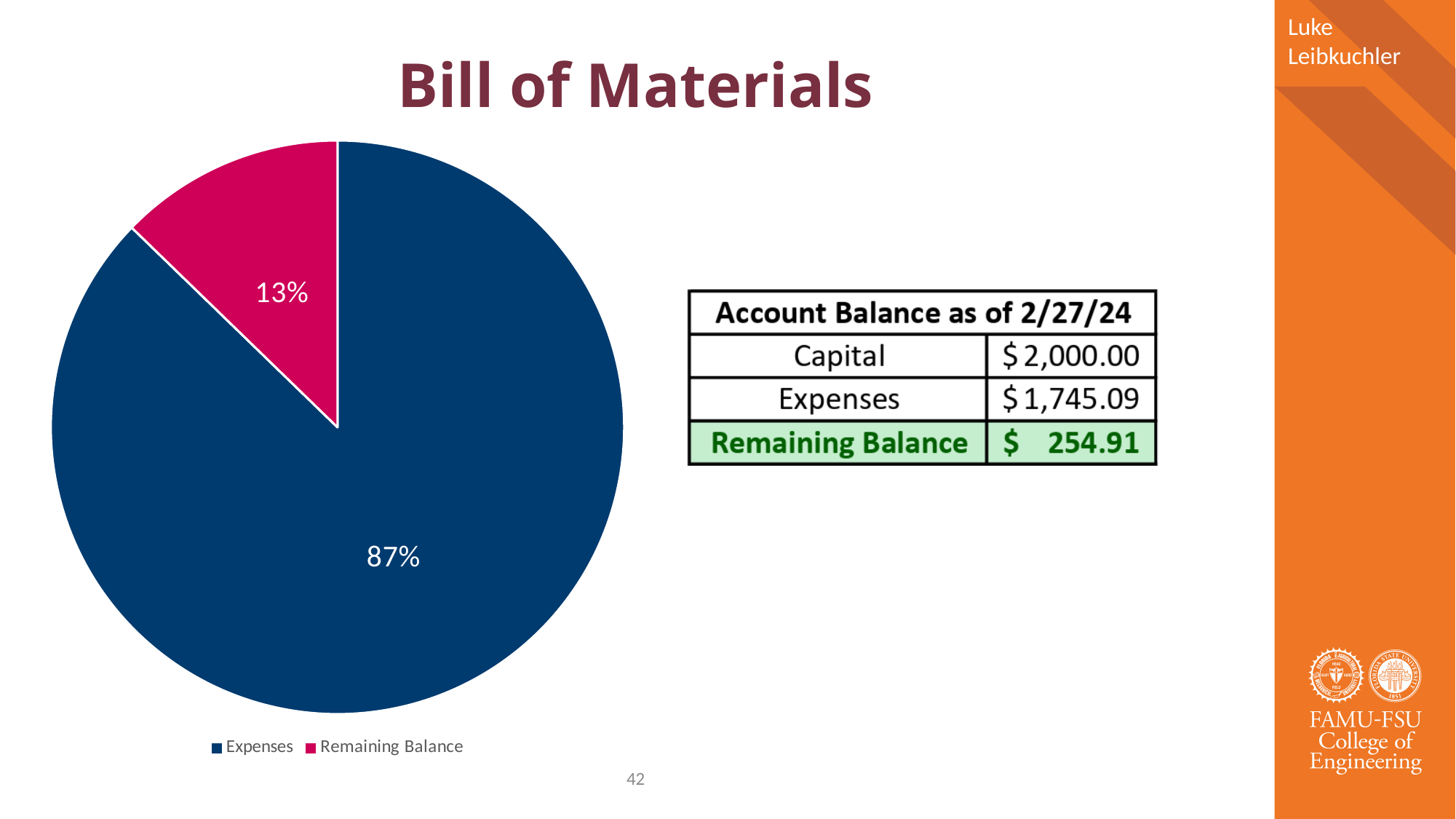
Which slice of the pie is the largest? Expenses Which is larger, the Expenses slice or the Remaining Balance slice? Expenses How many entries does the legend list? 2 Which slice of the pie is the smallest? Remaining Balance How many slices does the pie chart have? 2 What colour is the Remaining Balance slice? pink/magenta What share of the pie does Remaining Balance take? 13% What kind of chart is shown on the slide? pie chart What colour is the Expenses slice? dark blue What is the difference in percentage points between the Expenses slice and the Remaining Balance slice? 74 What share of the pie does Expenses take? 87%